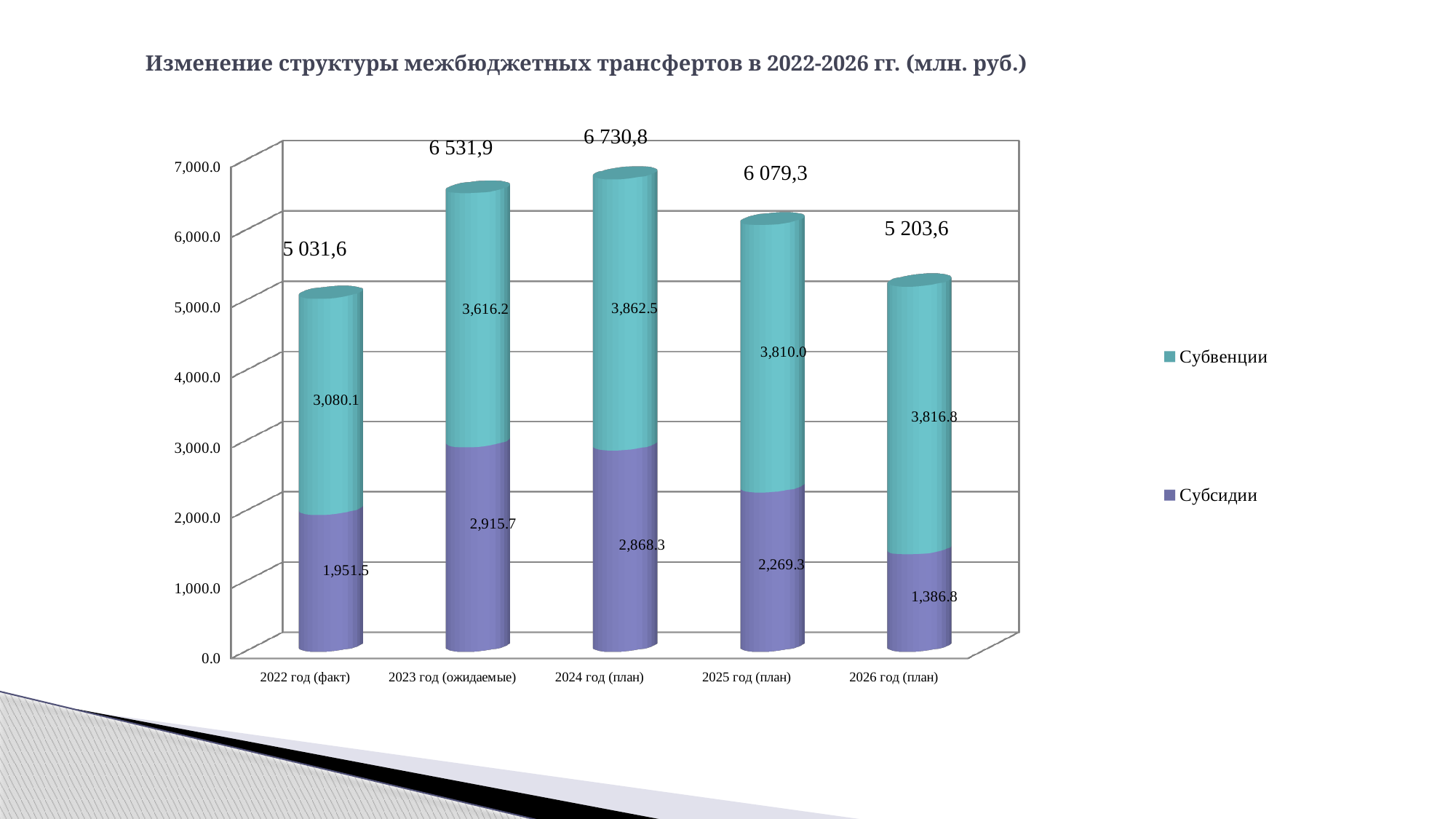
What is the difference between the Субвенции values for 2024 год (план) and 2022 год (факт)? 782.4 Which series is shown in purple in the legend? Субсидии Which category has the lowest Субсидии value? 2026 год (план) What kind of chart is shown on the slide? Stacked bar chart How many series does the legend list? 2 Which is larger: Субсидии for 2023 год (ожидаемые) or Субсидии for 2025 год (план)? 2023 год (ожидаемые) What is the total of the stacked bar for 2023 год (ожидаемые)? 6 531,9 What is the value of Субсидии for 2026 год (план)? 1,386.8 How many categories are shown on the x axis? 5 What is the value of Субсидии for 2022 год (факт)? 1,951.5 What is the value of Субвенции for 2024 год (план)? 3,862.5 Which category has the highest total stacked bar? 2024 год (план)